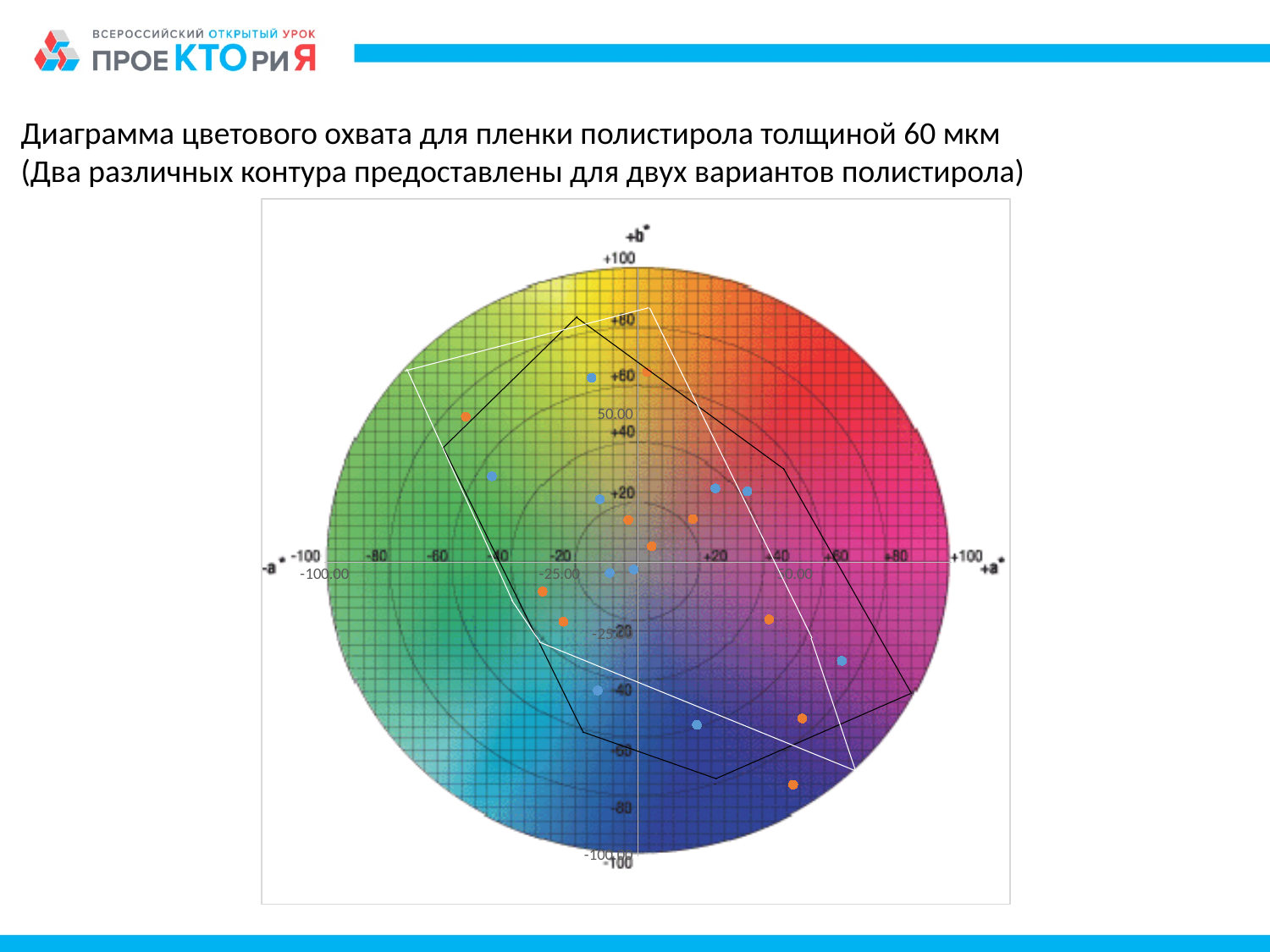
What is the title of the chart on the slide? Диаграмма цветового охвата для пленки полистирола толщиной 60 мкм How many contours are drawn on the colour gamut diagram? 2 What is the maximum value labelled on the +a* axis? +100 What kind of chart is shown on the slide? scatter chart Is the b* value of the highest blue point greater or less than +40? greater What is the minimum value labelled on the b* axis? -100 How many different colours of data points are plotted on the chart? 2 Is the b* value of the lowest orange point greater or less than -60? less